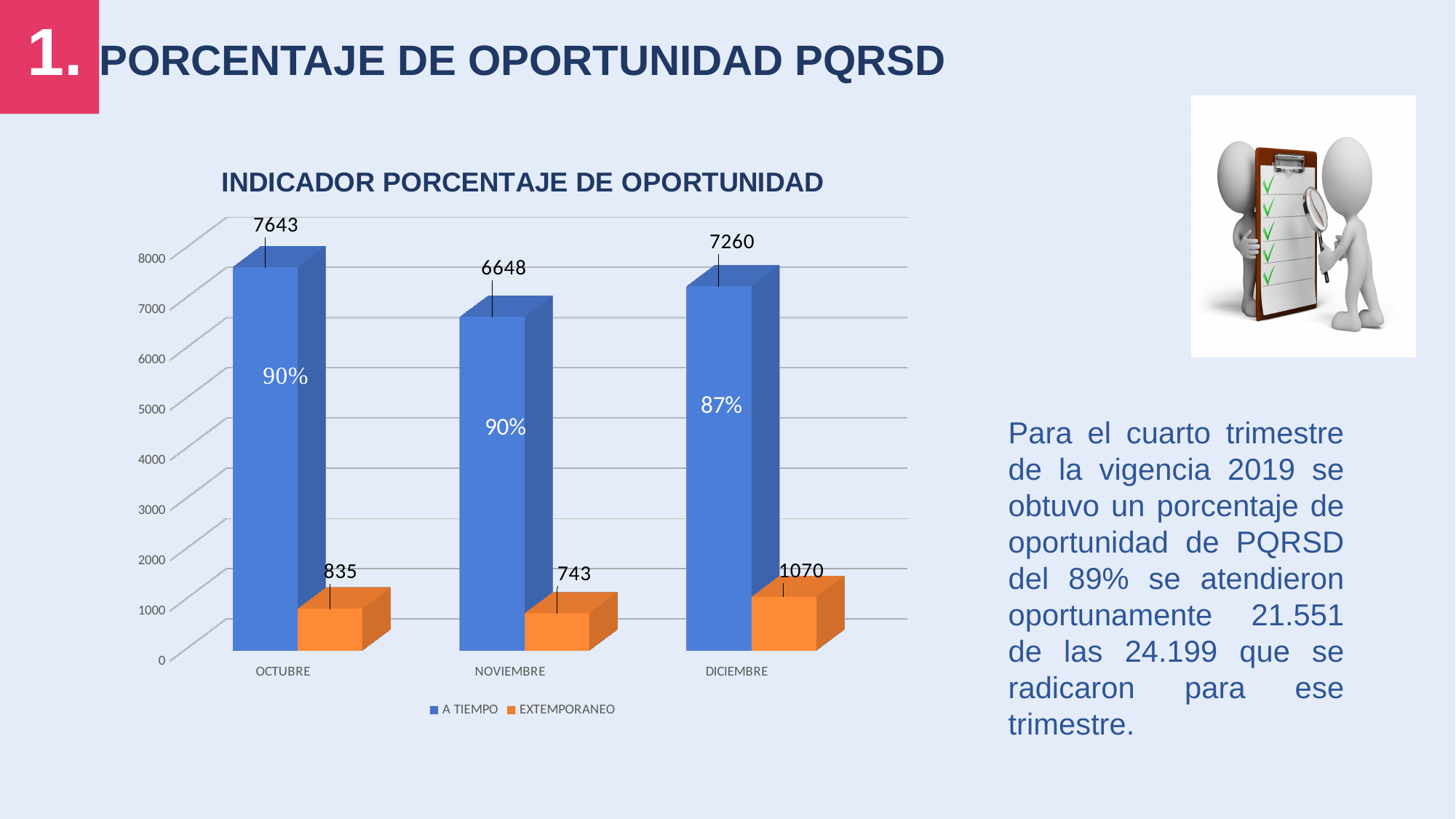
How many series does the legend list? 2 What is the difference between the A TIEMPO values for OCTUBRE and NOVIEMBRE? 995 Which month has the highest A TIEMPO value? OCTUBRE What is the title of the chart? INDICADOR PORCENTAJE DE OPORTUNIDAD What is the A TIEMPO value for NOVIEMBRE? 6648 What kind of chart is shown? Bar chart Which month has the lowest EXTEMPORANEO value? NOVIEMBRE What is the A TIEMPO value for OCTUBRE? 7643 What percentage is shown inside the A TIEMPO bar for DICIEMBRE? 87% How many months are shown on the x axis? 3 What is the EXTEMPORANEO value for DICIEMBRE? 1070 Which is larger, the EXTEMPORANEO value for OCTUBRE or for DICIEMBRE? DICIEMBRE